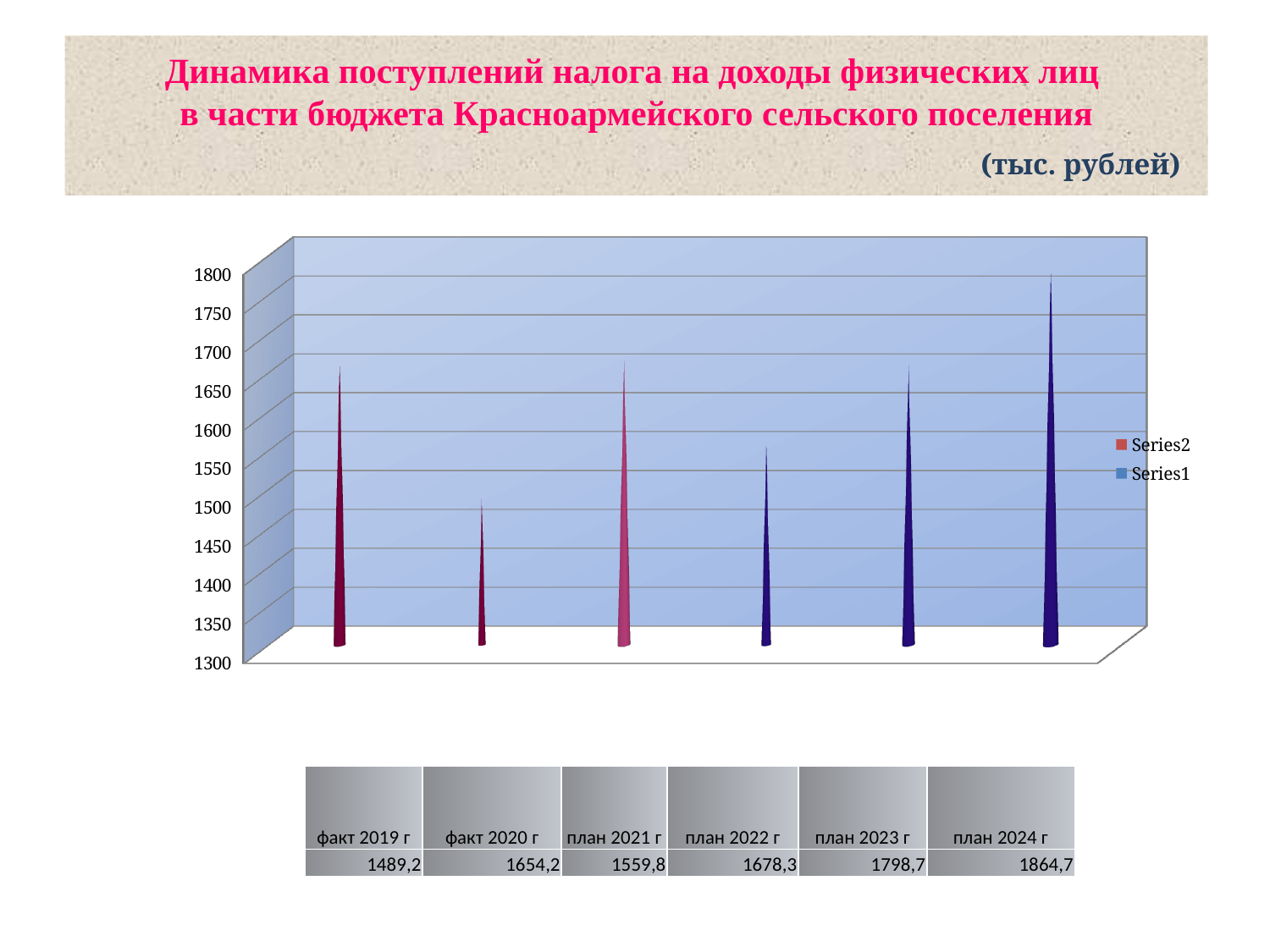
In what units are the values on the slide given? тыс. рублей How many series does the legend list? 2 What kind of chart is shown on the slide? bar chart What is the value for план 2022 г? 1678,3 What is the value for факт 2019 г? 1489,2 What is the value for план 2024 г? 1864,7 What is the difference between the values for план 2024 г and факт 2019 г? 375,5 What is the difference between the values for план 2023 г and план 2022 г? 120,4 Which category has the highest value? план 2024 г Which is larger, the value for план 2023 г or план 2022 г? план 2023 г What is the value for план 2023 г? 1798,7 How many categories are shown on the chart? 6